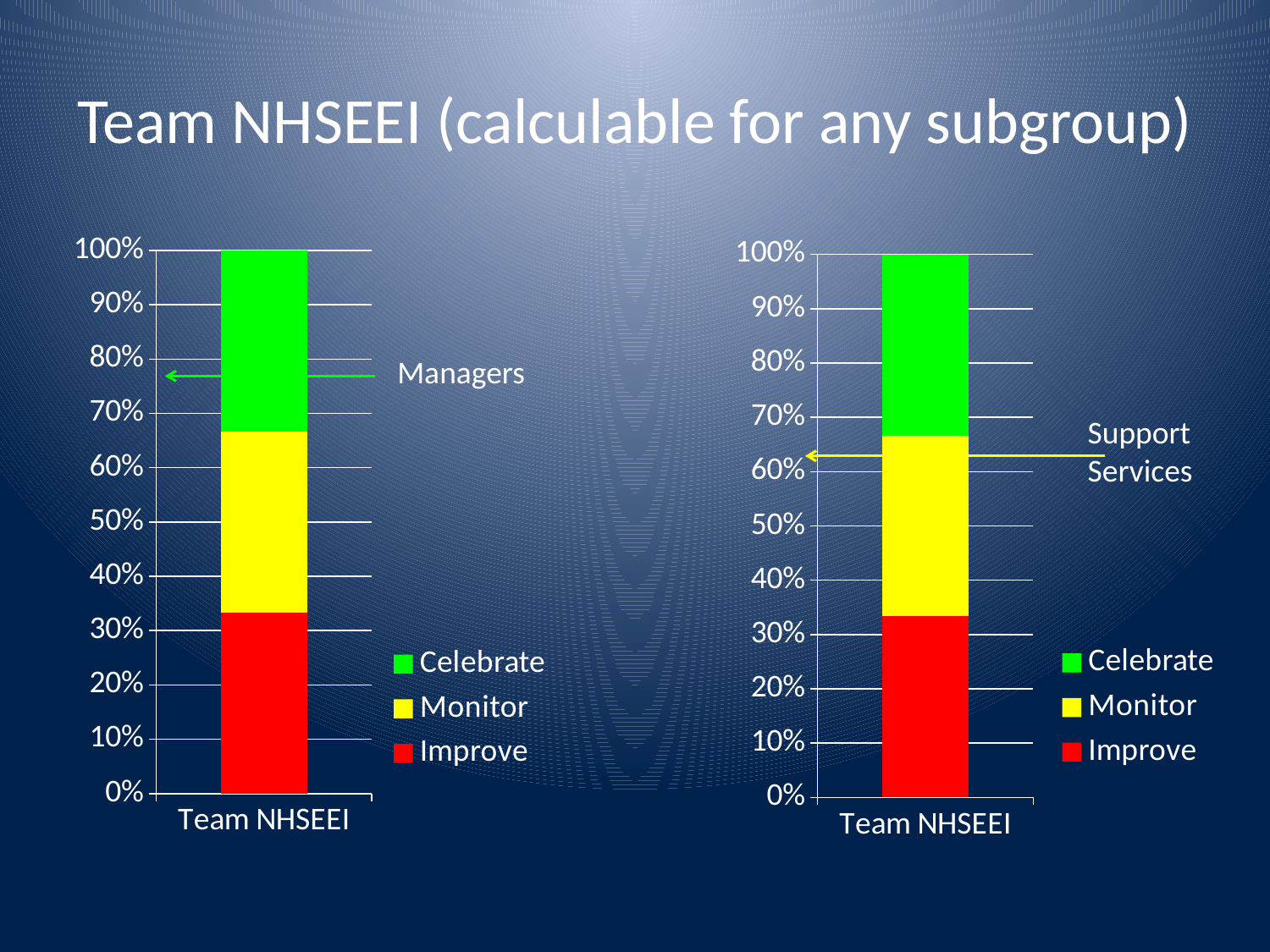
Which series is shown in yellow in the right chart (Support Services)? Monitor What is the title of the slide? Team NHSEEI (calculable for any subgroup) How many series does the legend of the right chart (Support Services) list? 3 In the left chart (Managers), is the Celebrate share for Team NHSEEI greater or less than 50%? less Which subgroup does the left chart represent, according to the label next to it? Managers What is the category label on the x axis of the right chart (Support Services)? Team NHSEEI In the left chart (Managers), is the Improve share for Team NHSEEI greater or less than 40%? less How many categories are shown on the x axis of the left chart (Managers)? 1 In the right chart (Support Services), is the Improve share for Team NHSEEI greater or less than 20%? greater In the left chart (Managers), what is the total height of the stacked bar for Team NHSEEI? 100% What kind of chart is the left chart (Managers)? stacked bar chart In the right chart (Support Services), what is the total height of the stacked bar for Team NHSEEI? 100%